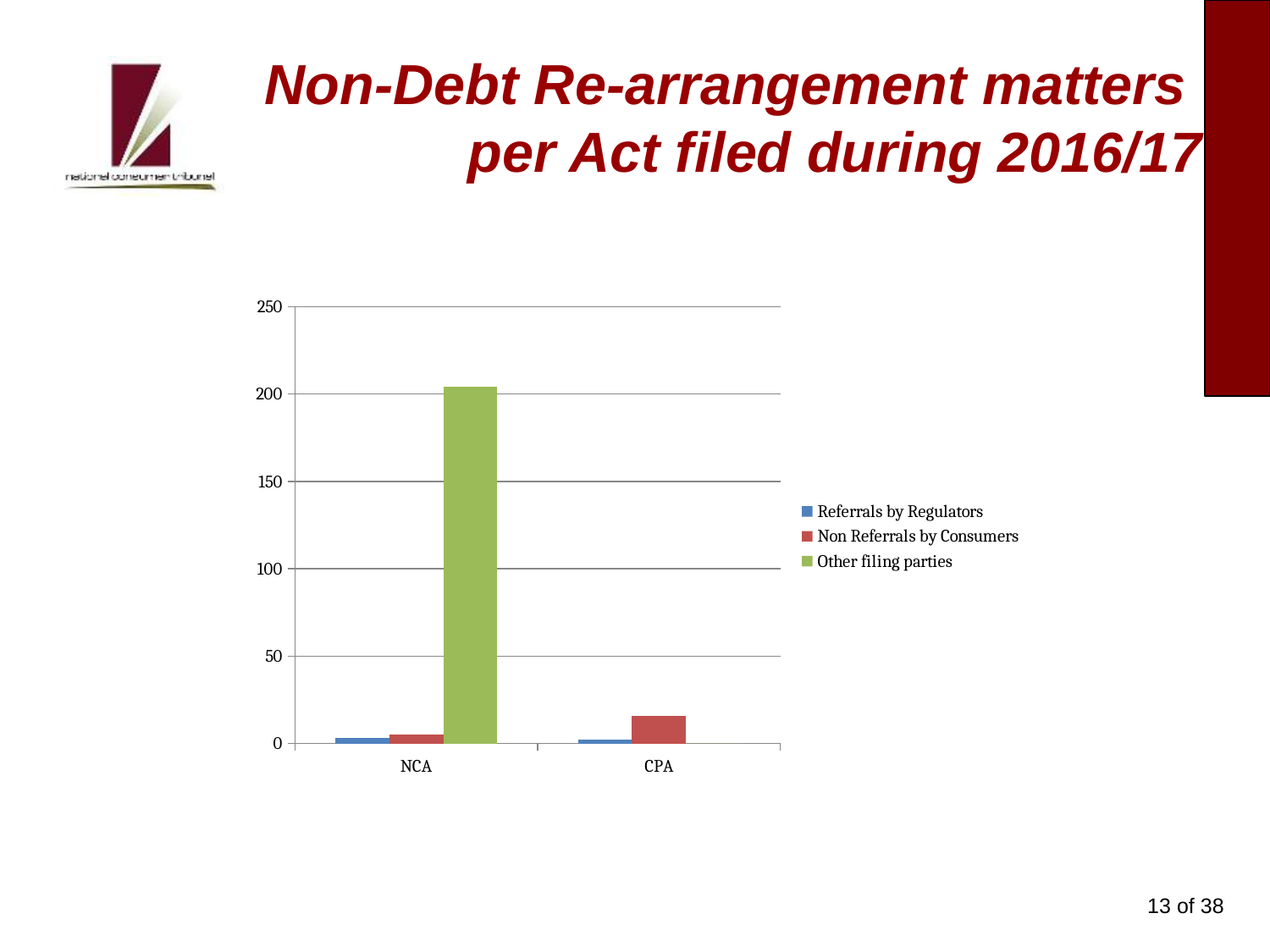
Which is larger: Non Referrals by Consumers for NCA or Non Referrals by Consumers for CPA? CPA Is the value for Other filing parties under NCA greater or less than 200? greater Is the value for Non Referrals by Consumers under CPA greater or less than 50? less Which series has the highest value for CPA? Non Referrals by Consumers What kind of chart is shown on the slide? bar chart Which series is shown in green in the chart's legend? Other filing parties Which is larger: Other filing parties for NCA or Other filing parties for CPA? NCA How many categories are shown on the x axis of the chart? 2 What is the title of the slide containing the chart? Non-Debt Re-arrangement matters per Act filed during 2016/17 Which series has the highest value for NCA? Other filing parties Is the value for Other filing parties under NCA greater or less than 250? less How many series does the chart's legend list? 3